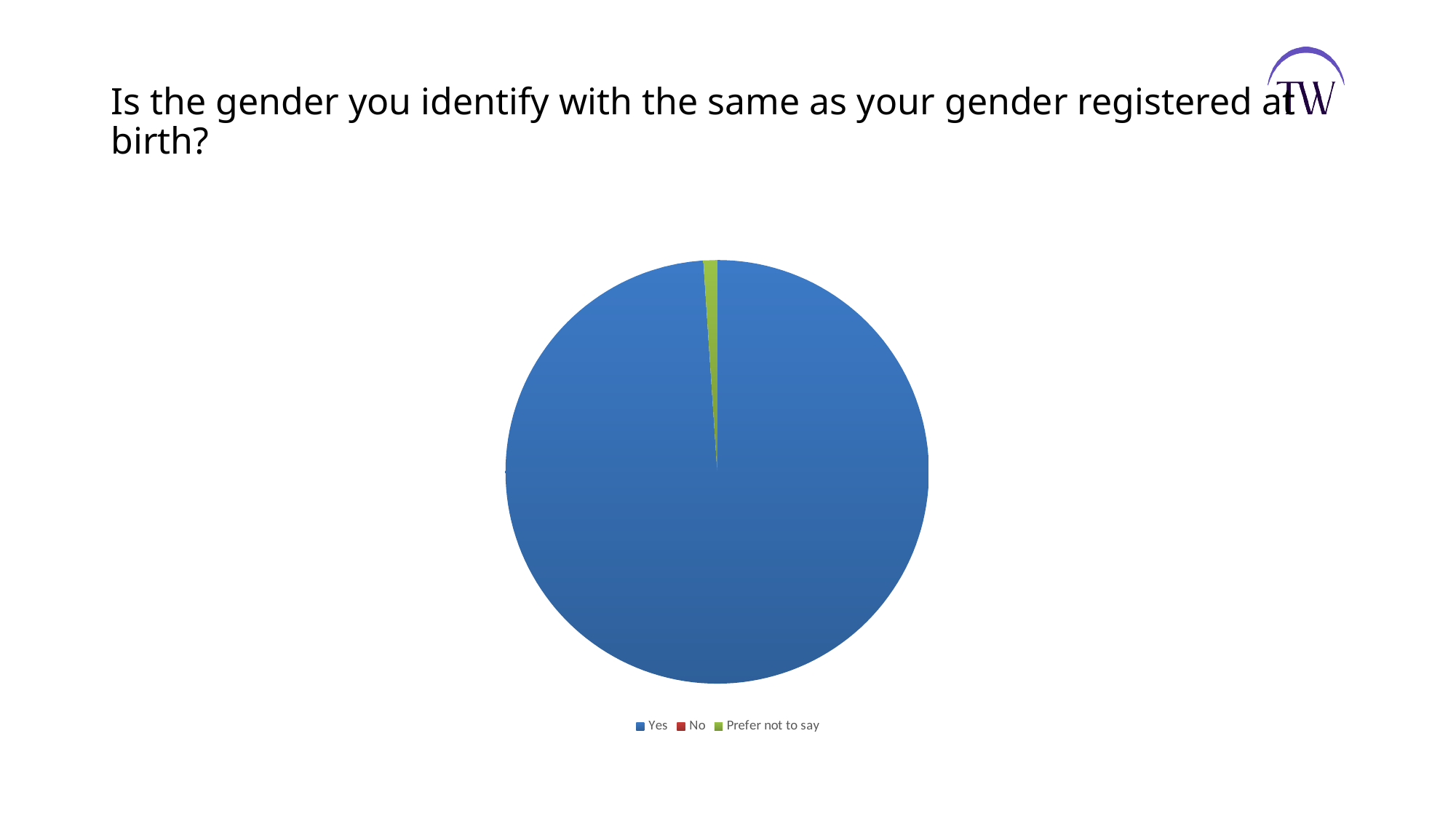
Which legend entry is shown in green in the pie chart? Prefer not to say Which category has the largest share of the pie chart? Yes What question is the pie chart titled with? Is the gender you identify with the same as your gender registered at birth? What colour represents the Yes category in the pie chart? blue Which is larger in the pie chart, the share for Yes or the share for Prefer not to say? Yes How many categories does the legend of the pie chart list? 3 What kind of chart is shown on the slide? pie chart